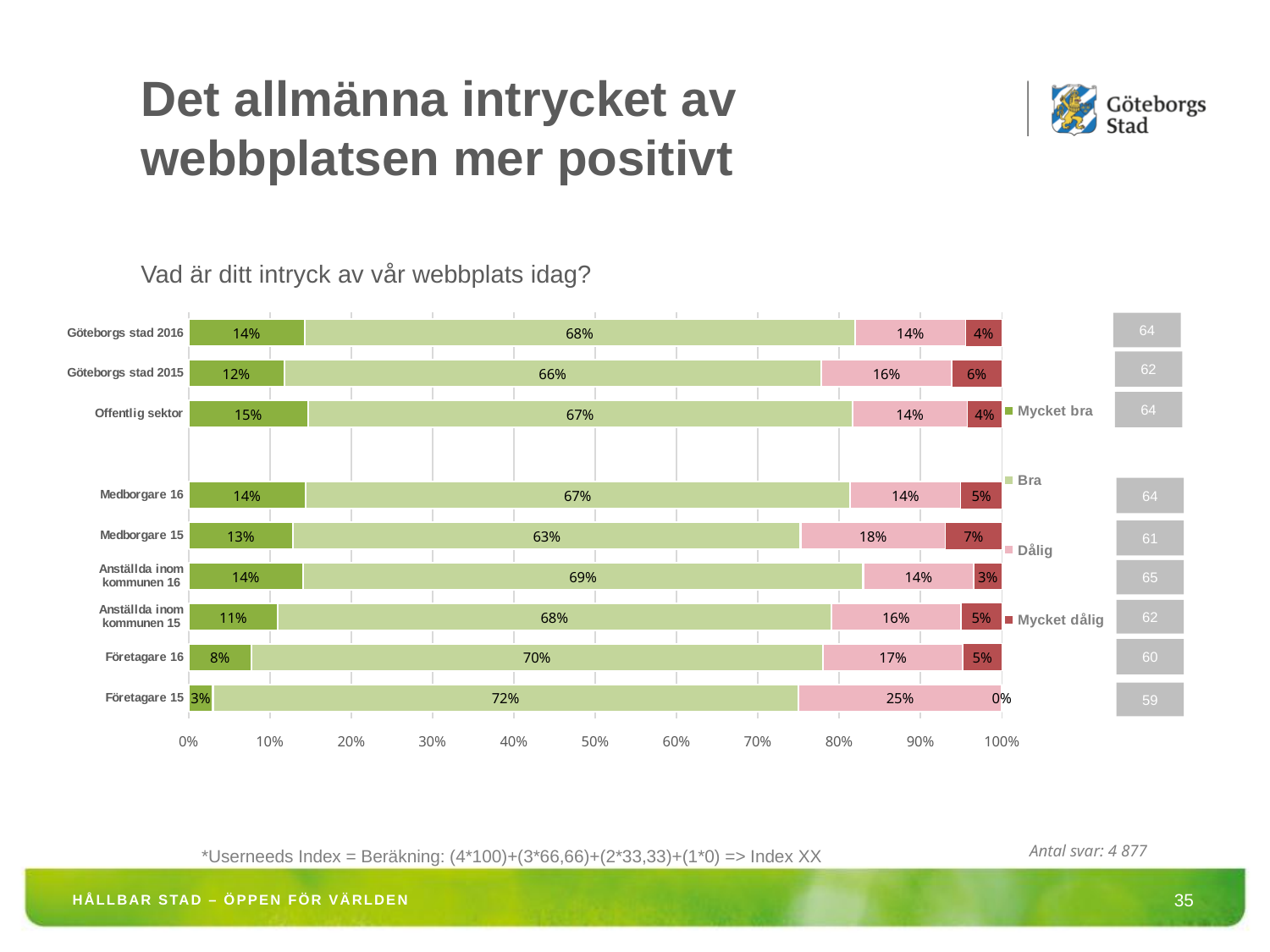
What is the "Mycket dålig" value for Anställda inom kommunen 16? 3% What is the difference between the "Dålig" values for Företagare 15 and Göteborgs stad 2016? 11% Which category has the lowest "Mycket bra" value? Företagare 15 How many categories are shown on the chart? 9 What is the question shown above the chart? Vad är ditt intryck av vår webbplats idag? What is the "Dålig" value for Medborgare 15? 18% How many series does the legend list? 4 What is the "Bra" value for Göteborgs stad 2016? 68% What kind of chart is shown on the slide? Stacked bar chart Which category has the highest "Bra" value? Företagare 15 Which is larger, the "Mycket bra" value for Offentlig sektor or for Medborgare 16? Offentlig sektor What is the "Mycket bra" value for Företagare 15? 3%